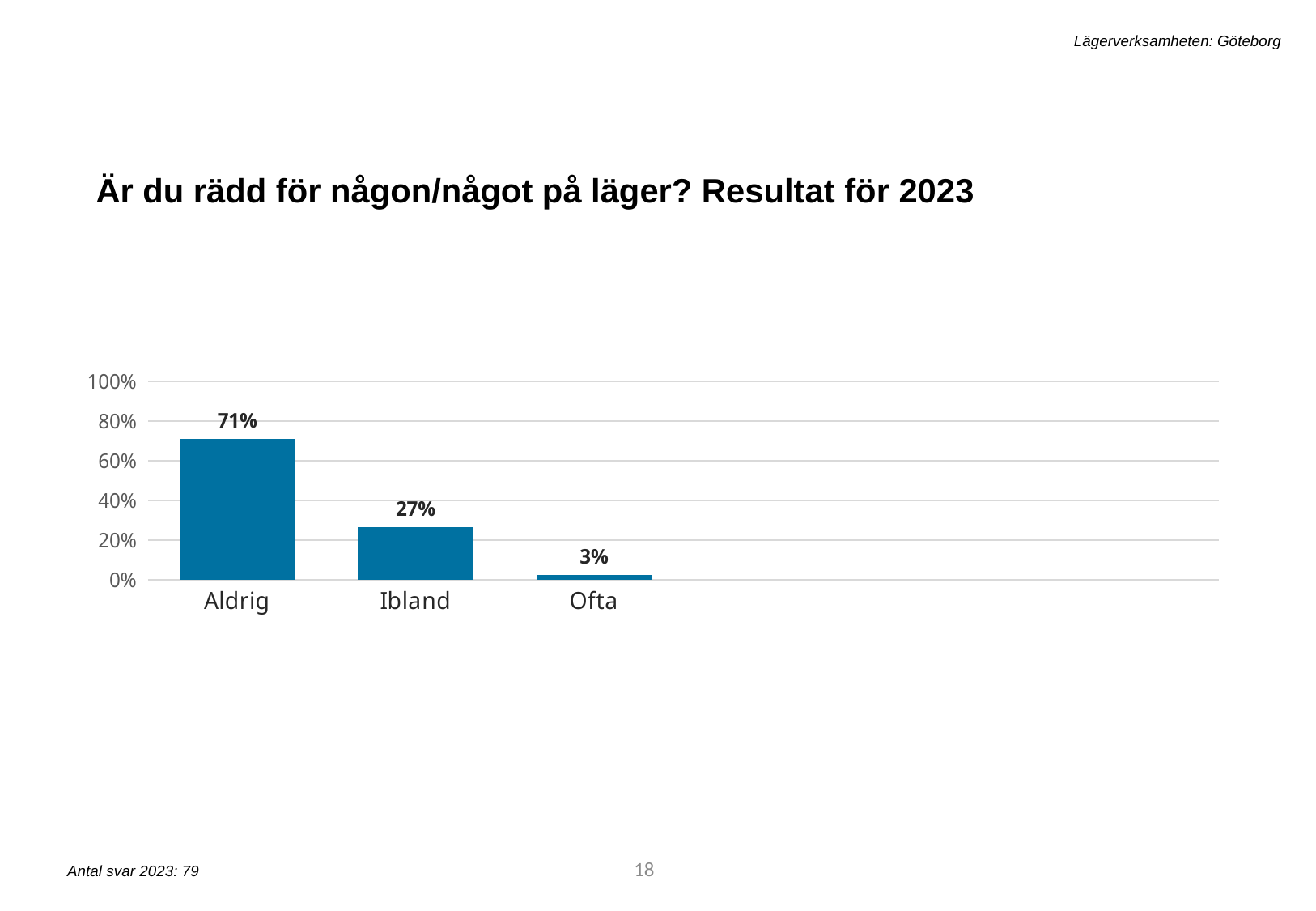
What is the difference between the values for Ibland and Ofta? 24% Is the value for Aldrig greater or less than 60%? greater Which category has the lowest value? Ofta What is the value for Aldrig? 71% What is the value for Ibland? 27% Do the values rise or fall from left to right along the x axis? fall What is the value for Ofta? 3% Which is larger, the value for Ibland or the value for Ofta? Ibland What kind of chart is shown on the slide? bar chart What is the difference between the values for Aldrig and Ibland? 44% Which category has the highest value? Aldrig How many categories are shown on the x axis? 3